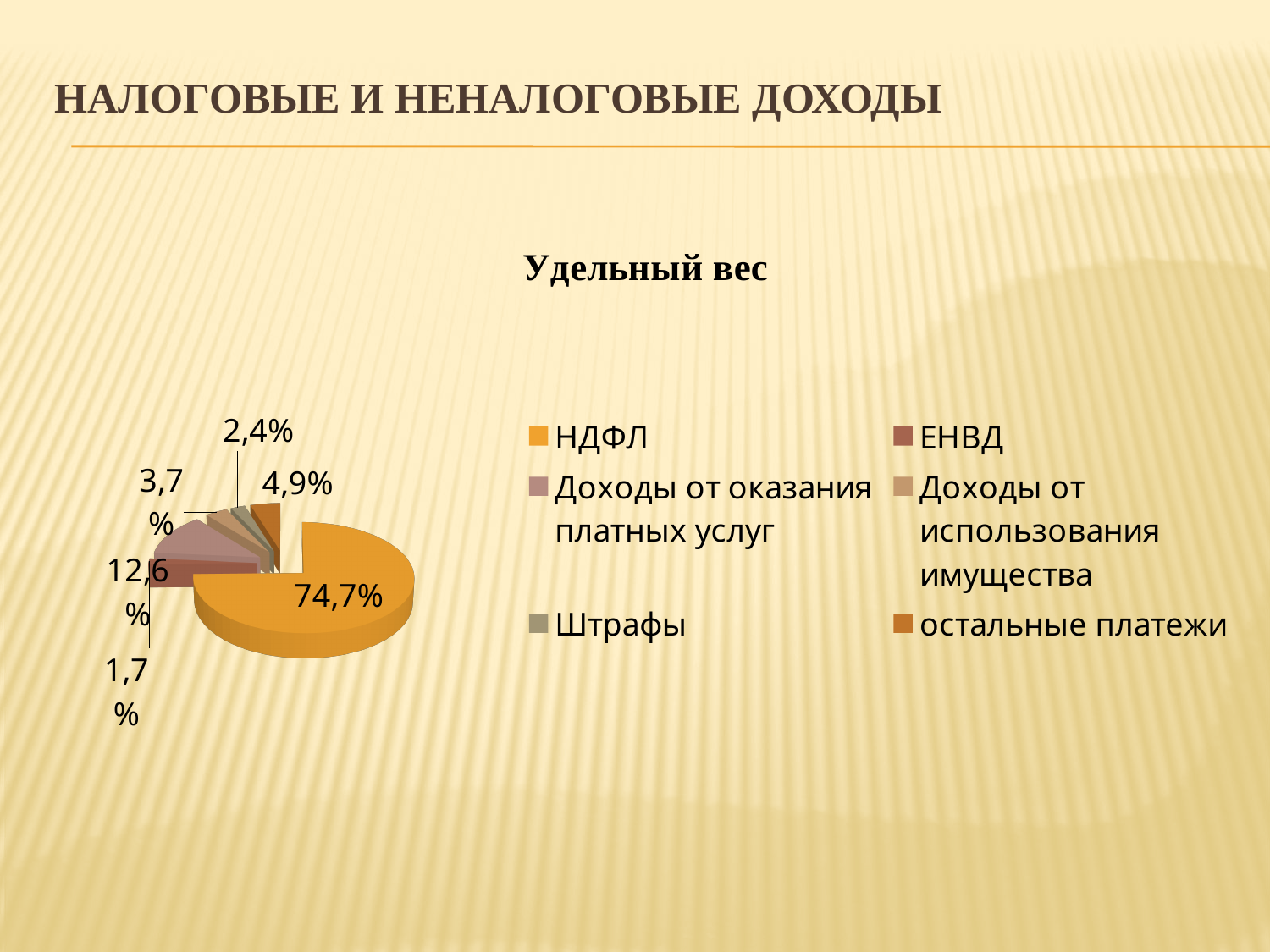
What share of the pie does Доходы от оказания платных услуг have? 12,6% What kind of chart is shown on the slide? pie chart What share of the pie does НДФЛ have? 74,7% Which category has the smallest share of the pie? ЕНВД What share of the pie does Штрафы have? 2,4% How many categories does the legend list? 6 What share of the pie does остальные платежи have? 4,9% What share of the pie does Доходы от использования имущества have? 3,7% What is the difference between the share for НДФЛ and the share for Доходы от оказания платных услуг? 62,1% Which is larger: the share for остальные платежи or the share for Штрафы? остальные платежи What is the title of the chart? Удельный вес Which category has the largest share of the pie? НДФЛ